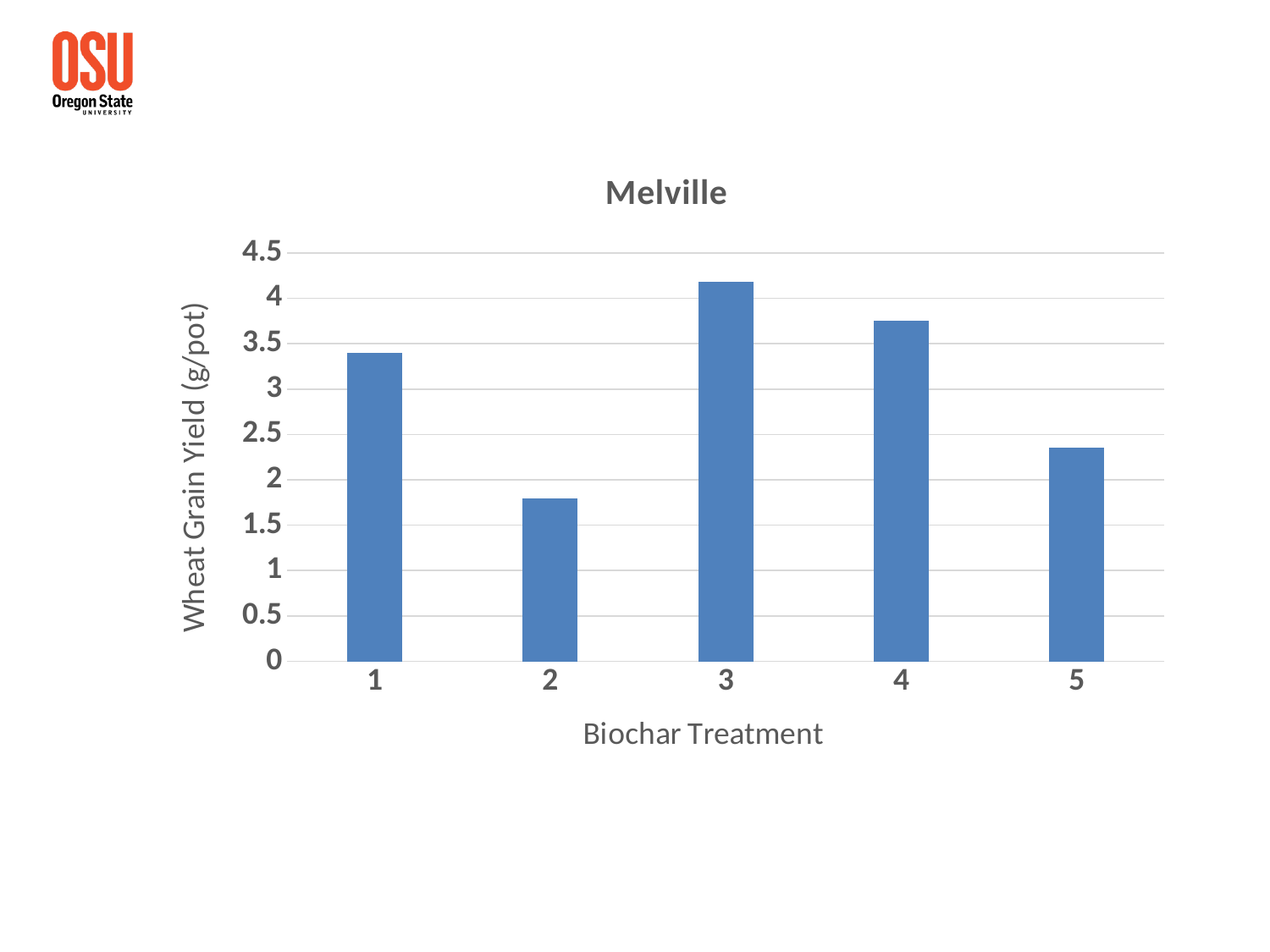
What is the label of the vertical axis? Wheat Grain Yield (g/pot) Is the wheat grain yield for treatment 4 greater or less than 3.5? greater Is the wheat grain yield for treatment 3 greater or less than 4? greater Which has the larger wheat grain yield, treatment 5 or treatment 1? 1 Is the wheat grain yield for treatment 2 greater or less than 2? less Which biochar treatment has the lowest wheat grain yield? 2 Which has the larger wheat grain yield, treatment 1 or treatment 4? 4 Which biochar treatment has the highest wheat grain yield? 3 What is the title of the chart? Melville How many biochar treatments are plotted on the chart? 5 What kind of chart is shown on the slide? bar chart